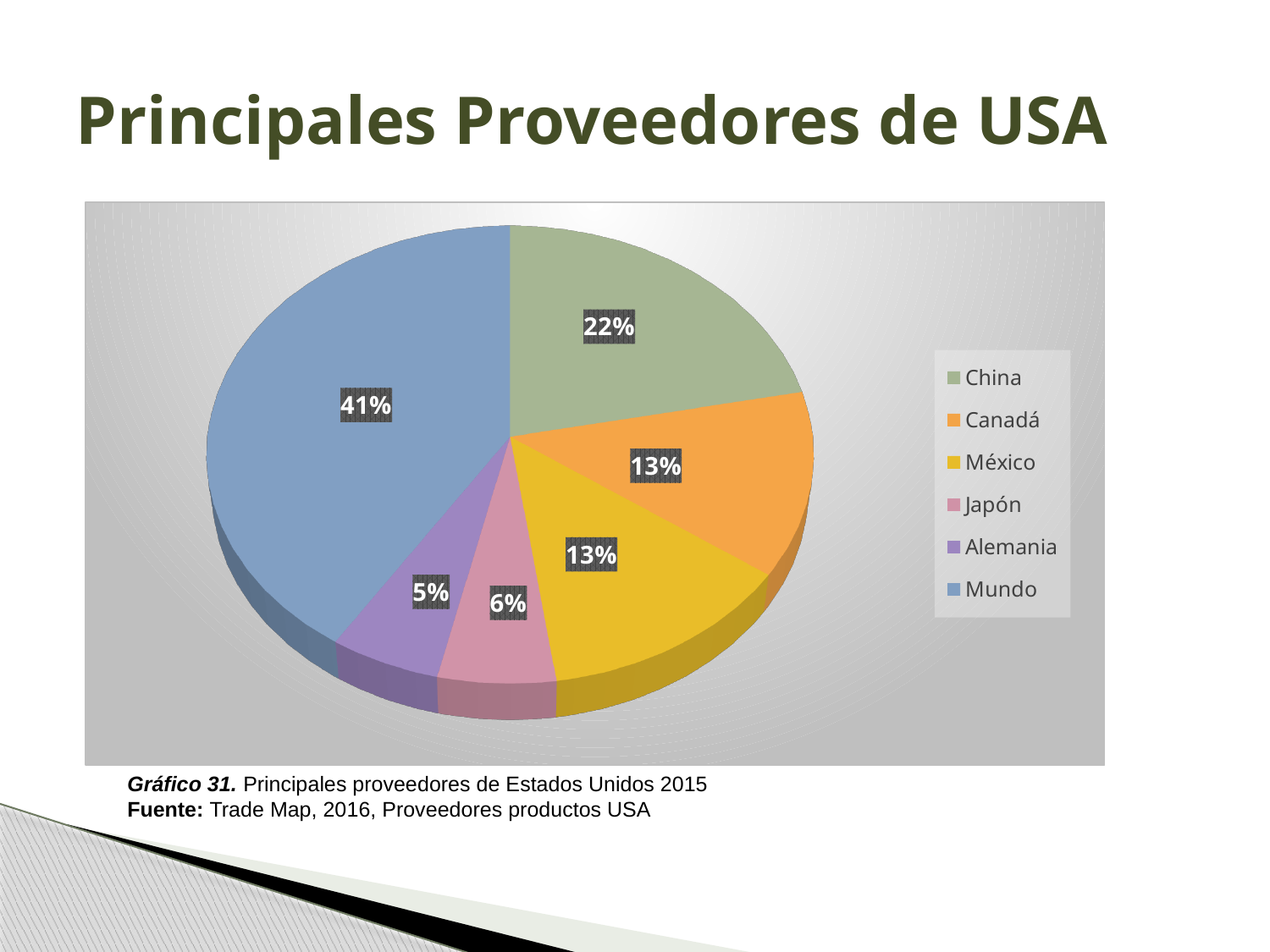
What is the value shown for Alemania? 5% How many categories does the legend list? 6 Which category has the smallest slice of the pie? Alemania What is the value shown for Japón? 6% What kind of chart is shown on the slide? pie chart What is the value shown for Mundo? 41% What is the difference between the shares of Mundo and China? 19% What is the title of the slide containing the chart? Principales Proveedores de USA What share of the pie does China have? 22% Which is larger, the slice for China or the slice for México? China What is the value shown for Canadá? 13% Which category has the largest slice of the pie? Mundo